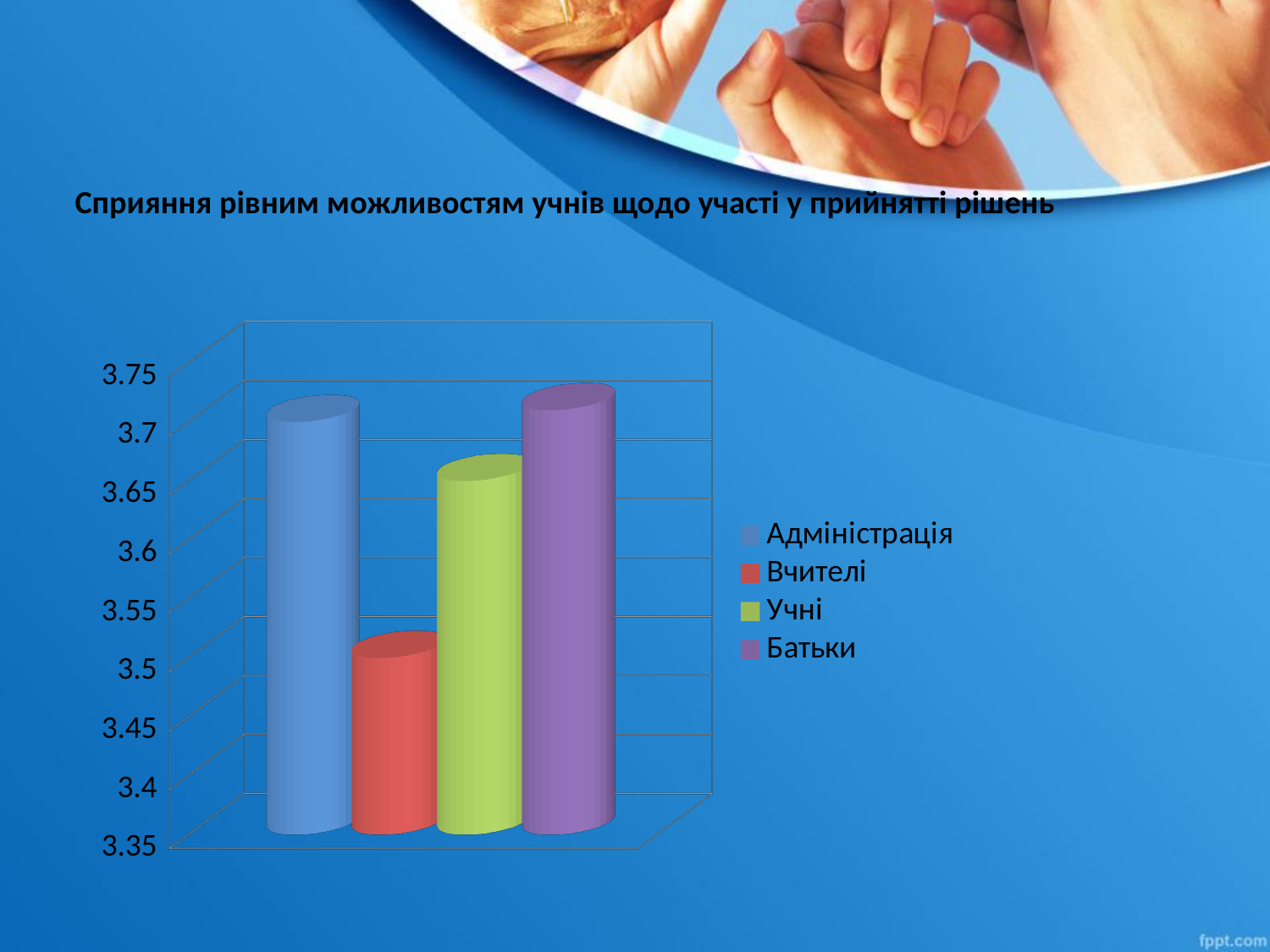
How many series does the legend list? 4 Is the value for Батьки greater or less than 3.75? less Is the value for Вчителі greater or less than 3.6? less How many bars are plotted in the chart? 4 Is the value for Адміністрація greater or less than 3.65? greater Which is larger, the value for Учні or the value for Вчителі? Учні What colour is the bar for Учні? green Which is larger, the value for Батьки or the value for Учні? Батьки What kind of chart is shown on the slide? bar chart Which series has the lowest value in the chart? Вчителі